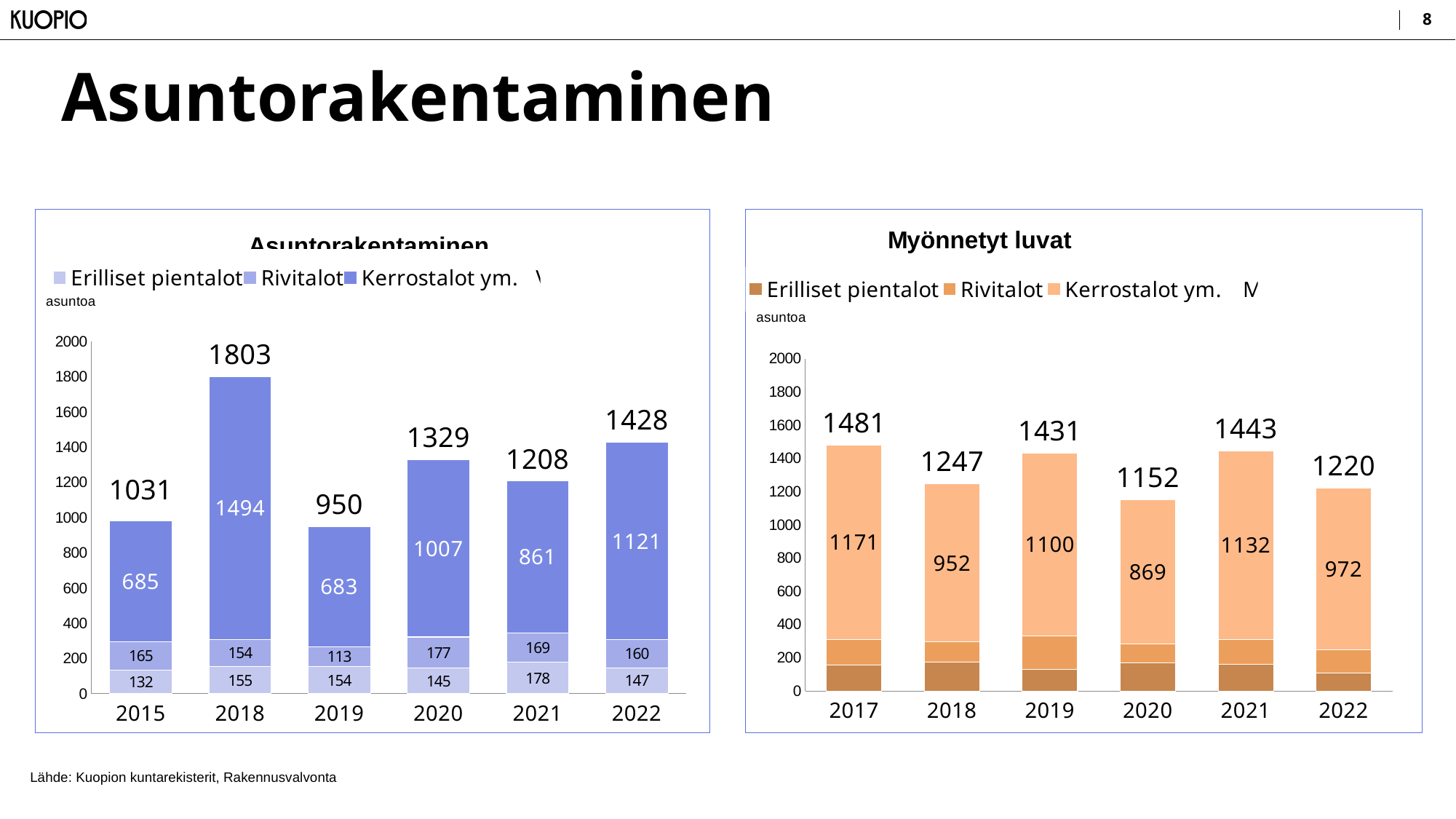
In the Asuntorakentaminen chart on the left, what is the Rivitalot value for 2019? 113 In the Asuntorakentaminen chart on the left, which year has the highest total? 2018 In the Asuntorakentaminen chart on the left, what is the total value shown above the bar for 2018? 1803 In the Asuntorakentaminen chart on the left, what is the Erilliset pientalot value for 2021? 178 In the Myönnetyt luvat chart on the right, which year has the lowest total? 2020 In the Myönnetyt luvat chart on the right, what is the total value shown above the bar for 2020? 1152 In the Asuntorakentaminen chart on the left, what is the Kerrostalot ym. value for 2020? 1007 In the Myönnetyt luvat chart on the right, which year has the larger total, 2017 or 2019? 2017 In the Myönnetyt luvat chart on the right, what is the Kerrostalot ym. value for 2021? 1132 In the Myönnetyt luvat chart on the right, how many years are shown on the x axis? 6 In the Asuntorakentaminen chart on the left, what is the difference between the totals for 2022 and 2021? 220 In the Asuntorakentaminen chart on the left, which year has the lowest total? 2019